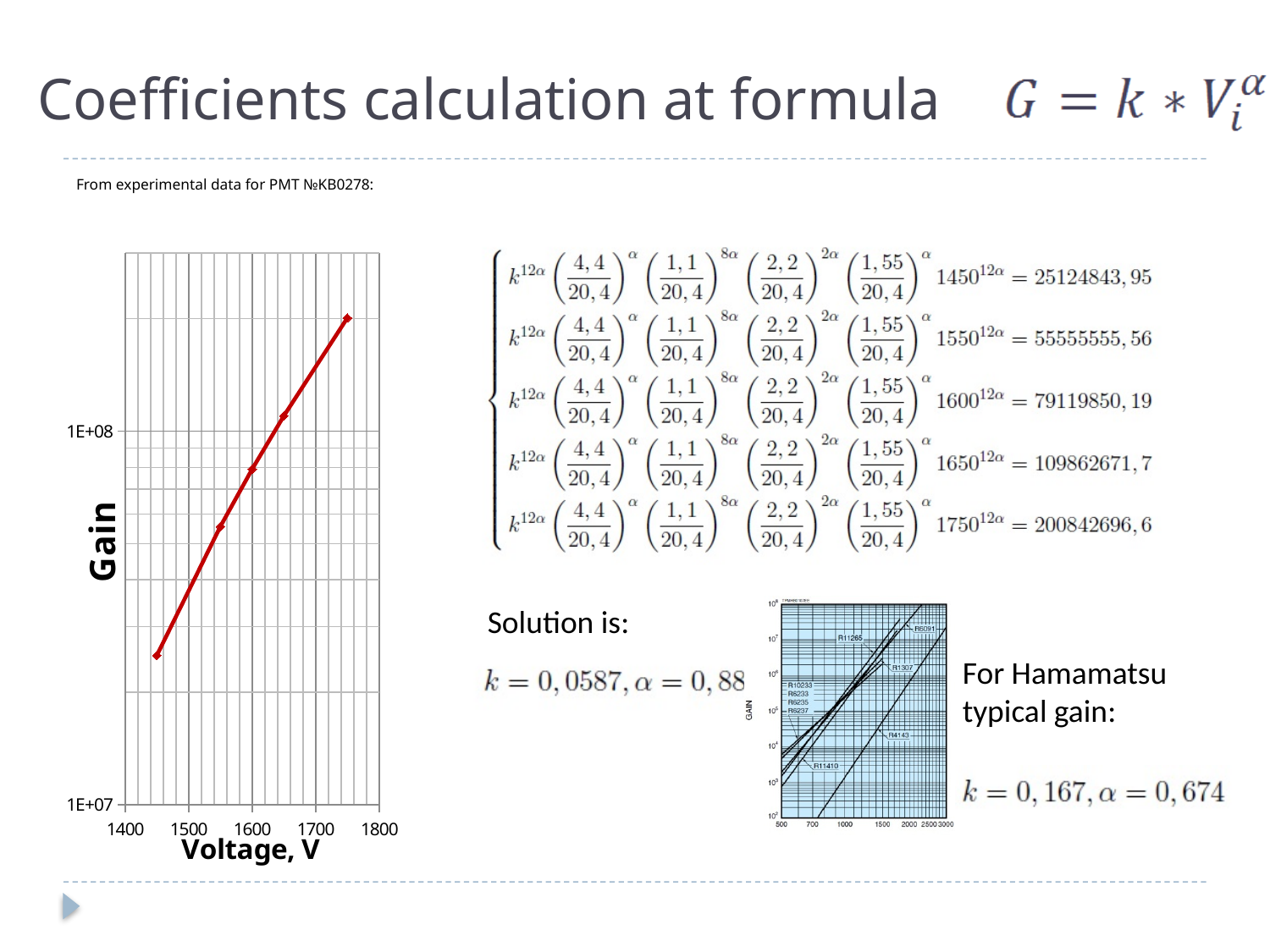
On the Gain versus Voltage chart, is the gain at 1750 V greater or less than 1E+08? greater What is the x-axis title of the Gain versus Voltage chart? Voltage, V On the Gain versus Voltage chart, at which voltage is the gain highest? 1750 On the Gain versus Voltage chart, is the gain at 1450 V greater or less than 1E+08? less On the Gain versus Voltage chart, at which voltage is the gain lowest? 1450 What kind of chart is the Gain versus Voltage chart on the left of the slide? line chart On the Gain versus Voltage chart, is the gain at 1600 V greater or less than 1E+08? less On the Gain versus Voltage chart, which has the larger gain: 1550 V or 1650 V? 1650 V What is the y-axis title of the chart on the left of the slide? Gain How many data points are plotted on the Gain versus Voltage chart? 5 On the Gain versus Voltage chart, does the gain rise or fall as the voltage increases? rise